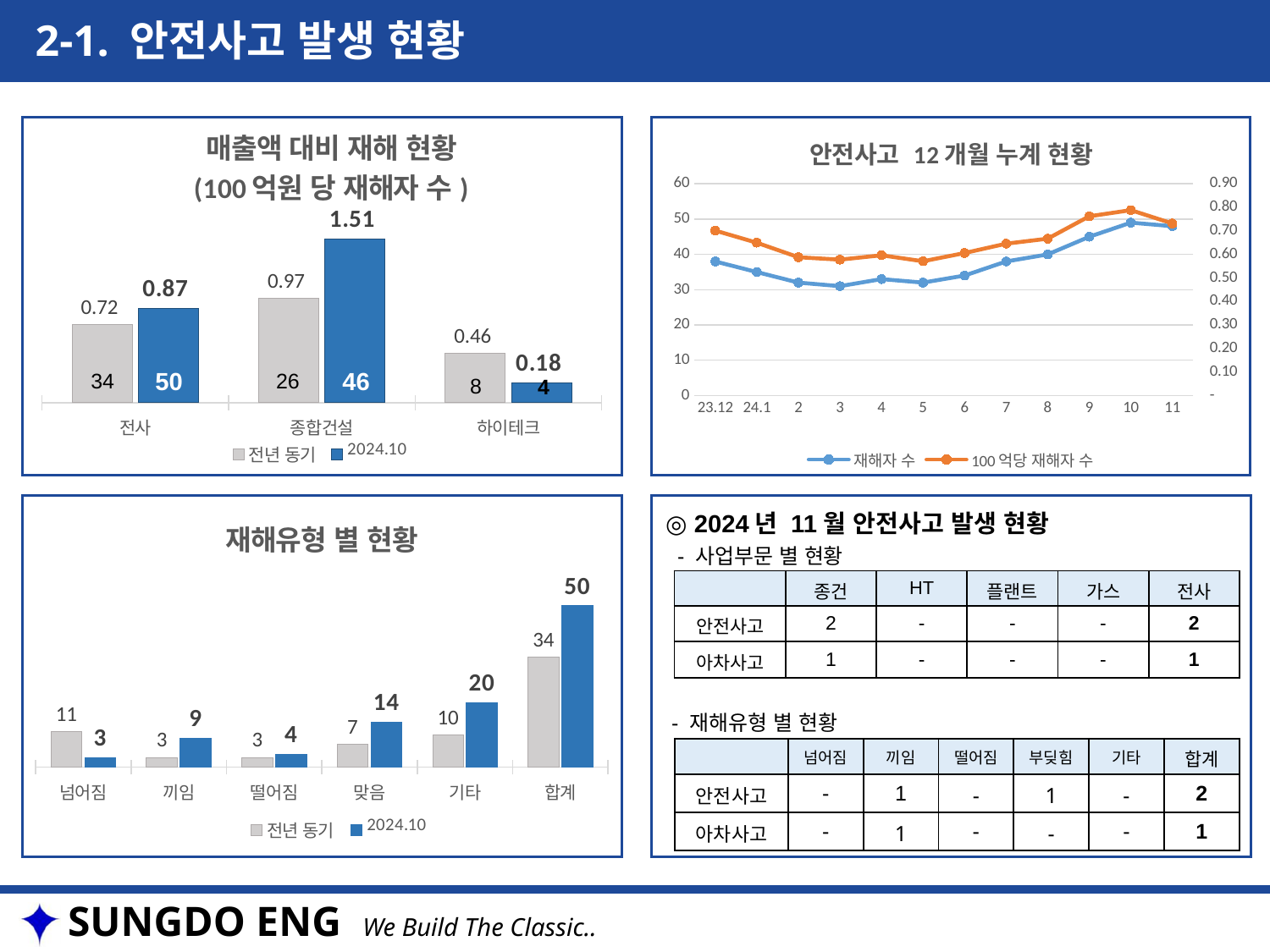
In the chart titled 매출액 대비 재해 현황, what is the 전년 동기 value for 하이테크? 0.46 In the chart titled 안전사고 12개월 누계 현황, is the 재해자 수 value at 23.12 greater or less than 40? less In the chart titled 안전사고 12개월 누계 현황, how many points are plotted along the x axis for each series? 12 In the chart titled 매출액 대비 재해 현황, what is the 2024.10 value for 종합건설? 1.51 In the chart titled 재해유형 별 현황, what is the difference between the 2024.10 value and the 전년 동기 value for 기타? 10 In the chart titled 매출액 대비 재해 현황, which is larger for 하이테크: the 전년 동기 value or the 2024.10 value? 전년 동기 In the chart titled 재해유형 별 현황, what is the 2024.10 value for 맞음? 14 What kind of chart is the chart titled 안전사고 12개월 누계 현황? line chart In the chart titled 재해유형 별 현황, how many categories are shown on the x axis? 6 In the chart titled 매출액 대비 재해 현황, how many series does the legend list? 2 In the chart titled 매출액 대비 재해 현황, which category has the highest 2024.10 value? 종합건설 In the chart titled 재해유형 별 현황, which category has the lowest 2024.10 value? 넘어짐